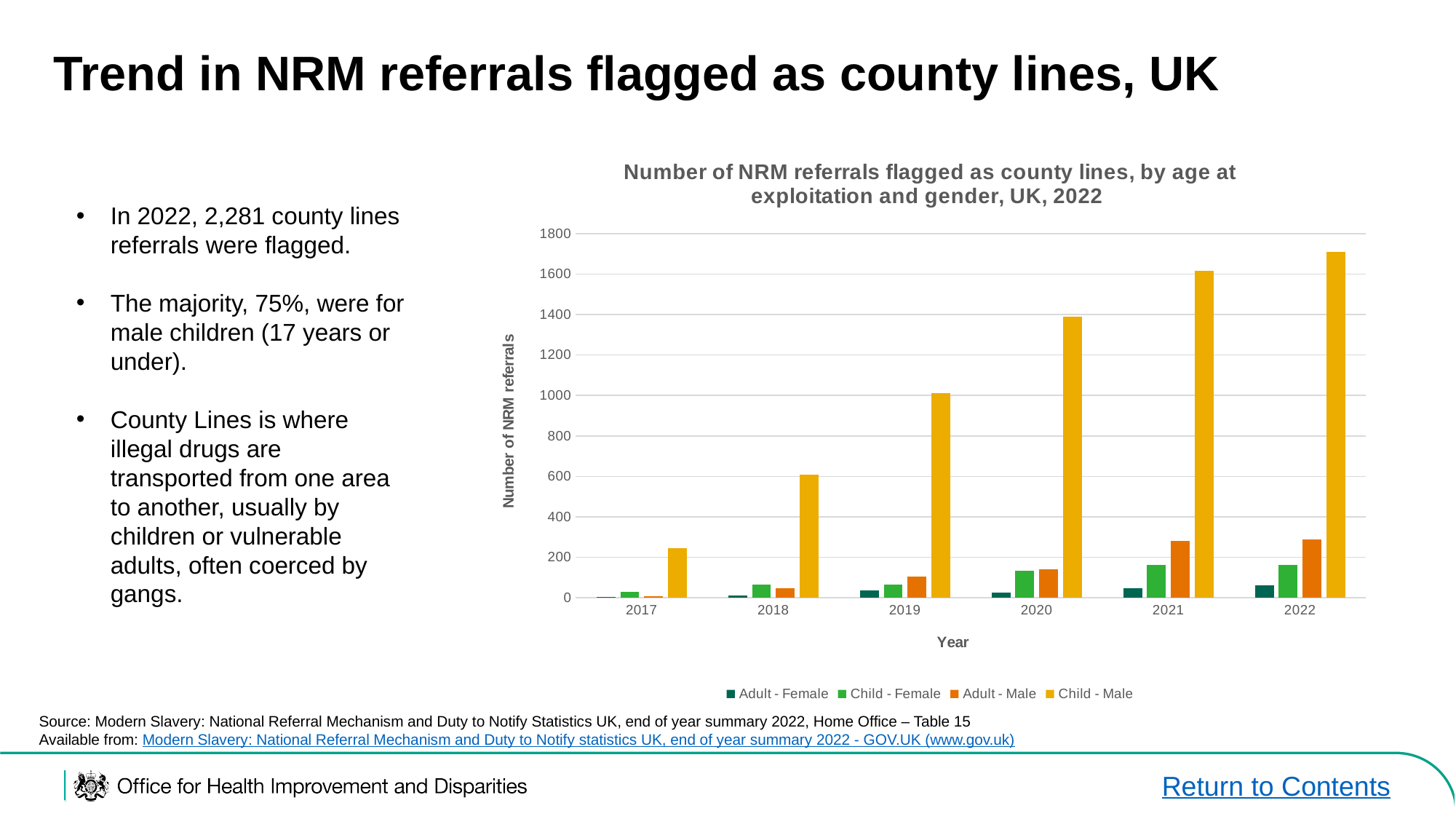
Is the value for Child - Female in 2021 greater or less than 200? less In 2022, which is larger: Adult - Male or Child - Female? Adult - Male Is the value for Child - Male in 2020 greater or less than 1200? greater Which year has the highest value for Child - Male? 2022 Which year has the lowest value for Child - Male? 2017 Is the value for Child - Male in 2022 greater or less than 1600? greater What type of chart is shown on the slide? Bar chart Do the values for Child - Male rise or fall from 2017 to 2022? Rise How many series does the legend list? 4 How many years are shown on the x axis? 6